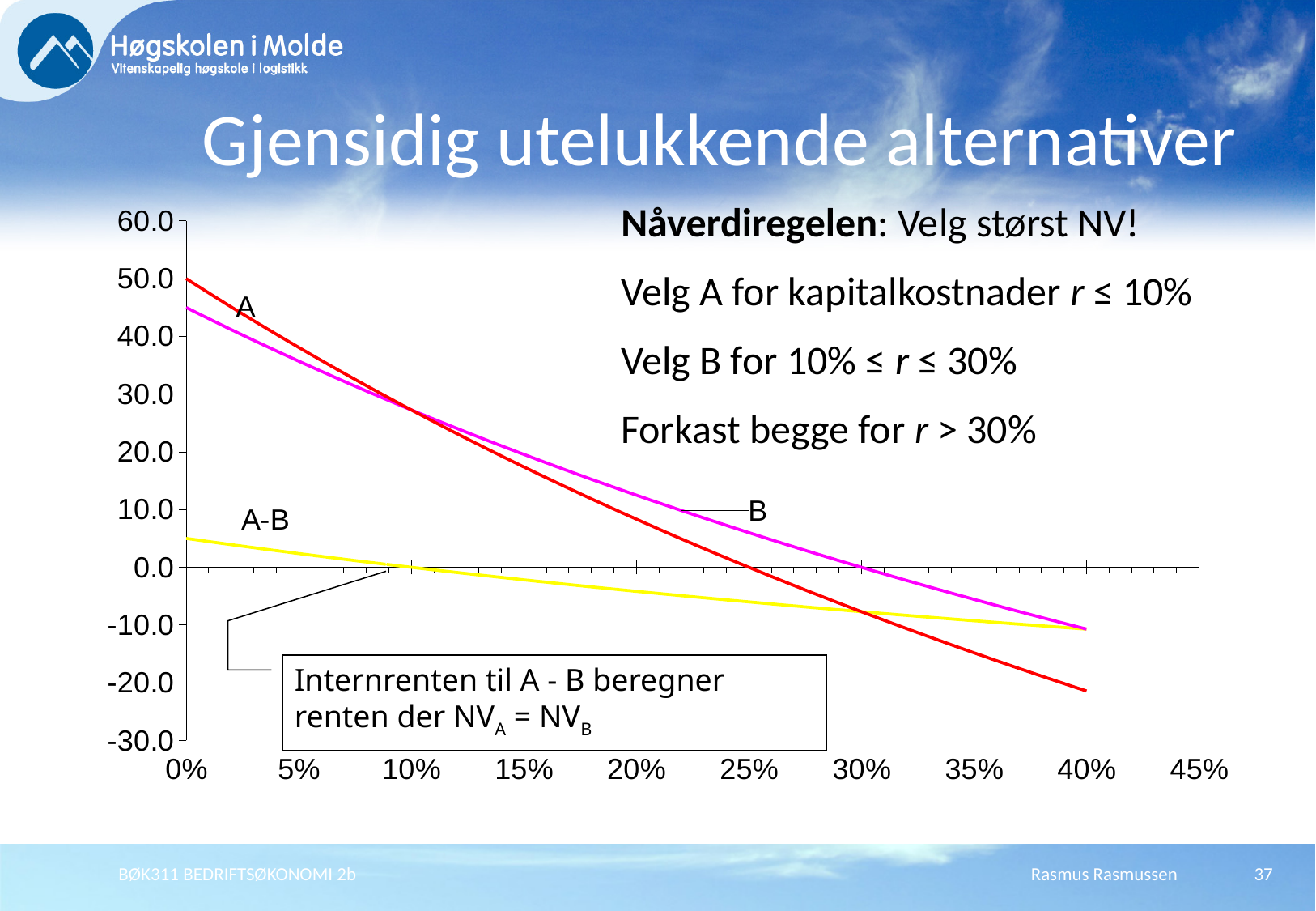
At what rate on the x axis does line A-B cross 0.0? 10% At what rate on the x axis does line A cross 0.0? 25% Do the values of line A rise or fall as the rate on the x axis increases? fall Which line has the highest value at 0%? A What is the value of line A at 0%? 50.0 How many lines are plotted on the chart? 3 Is the value of line A at 40% greater or less than -10.0? less What kind of chart is shown on the slide? line chart What are the labels of the three lines on the chart? A, B, A-B At 20%, which line is higher, A or B? B At what rate on the x axis does line B cross 0.0? 30% Which line has the lowest value at 40%? A